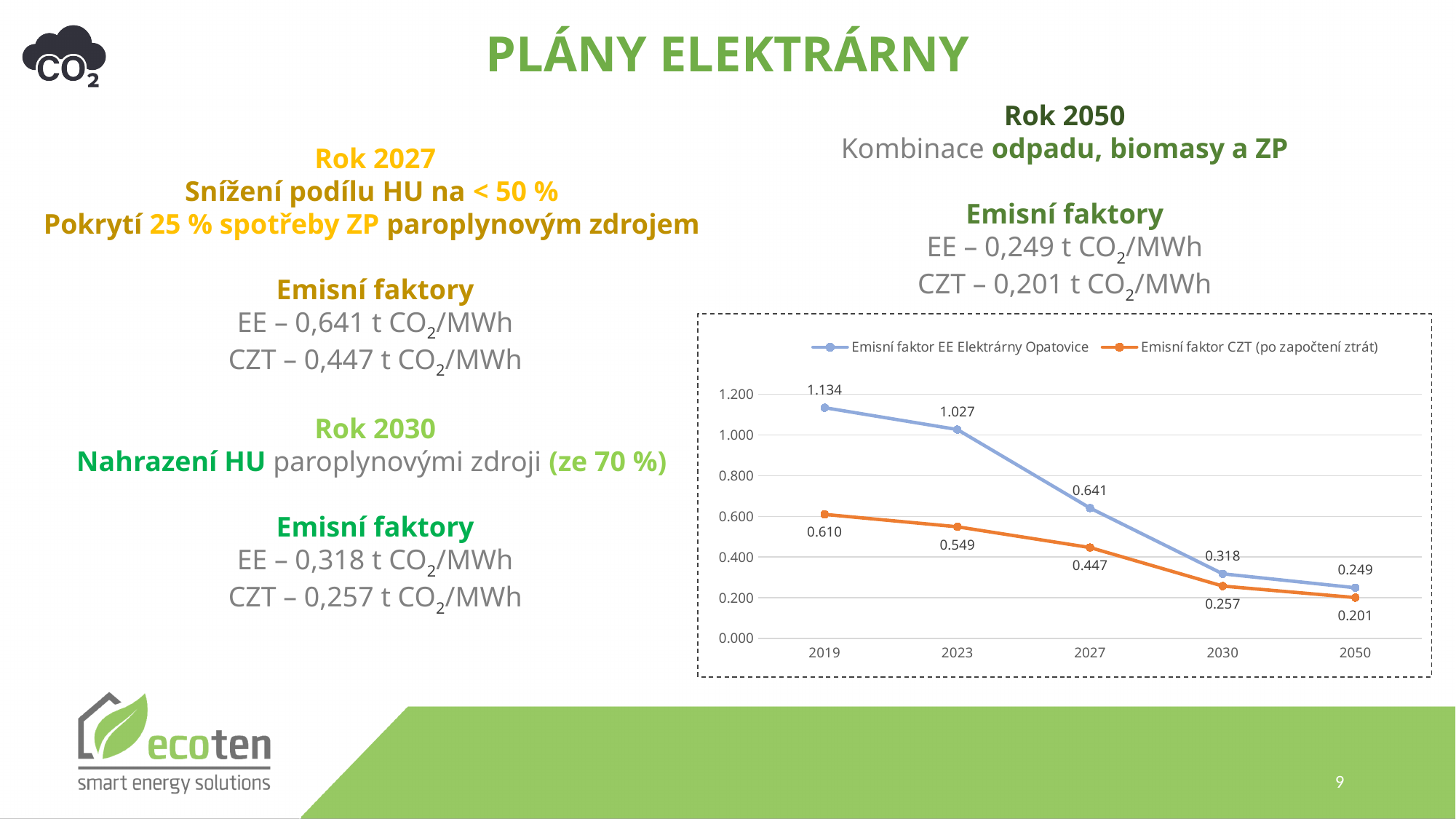
In which year is Emisní faktor EE Elektrárny Opatovice highest? 2019 What is the value of Emisní faktor EE Elektrárny Opatovice in 2019? 1.134 Which series has the larger value in 2030, Emisní faktor EE Elektrárny Opatovice or Emisní faktor CZT (po započtení ztrát)? Emisní faktor EE Elektrárny Opatovice Which colour is used for the Emisní faktor CZT (po započtení ztrát) line? orange What is the value of Emisní faktor CZT (po započtení ztrát) in 2027? 0.447 What is the value of Emisní faktor EE Elektrárny Opatovice in 2050? 0.249 How many years are plotted on the x axis of the chart? 5 What is the difference between Emisní faktor EE Elektrárny Opatovice and Emisní faktor CZT (po započtení ztrát) in 2023? 0.478 How many series does the chart legend list? 2 What type of chart is shown on the slide? line chart Do the values of Emisní faktor EE Elektrárny Opatovice rise or fall from 2019 to 2050? fall In which year is Emisní faktor CZT (po započtení ztrát) lowest? 2050